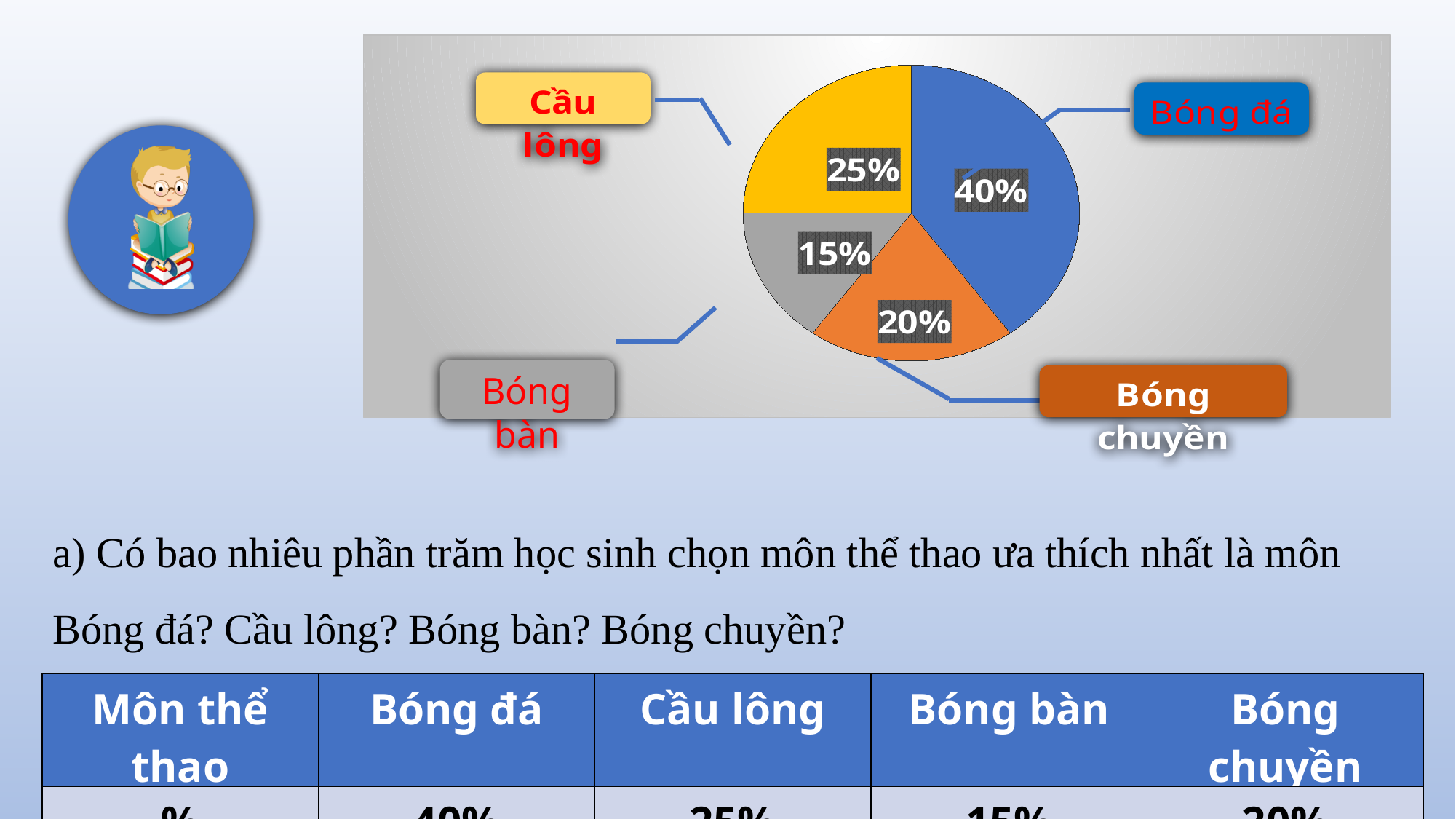
What is the difference in percentage points between Bóng đá and Cầu lông? 15% What percentage of the pie chart is Cầu lông? 25% Which sport has the largest slice of the pie chart? Bóng đá What colour is the Bóng chuyền slice in the pie chart? orange Which is larger, the slice for Bóng chuyền or the slice for Bóng bàn? Bóng chuyền What percentage of the pie chart is Bóng chuyền? 20% Which sport has the smallest slice of the pie chart? Bóng bàn How many slices does the pie chart have? 4 What percentage of the pie chart is Bóng đá? 40% What kind of chart is shown on the slide? pie chart What colour is the Cầu lông slice in the pie chart? yellow What percentage of the pie chart is Bóng bàn? 15%